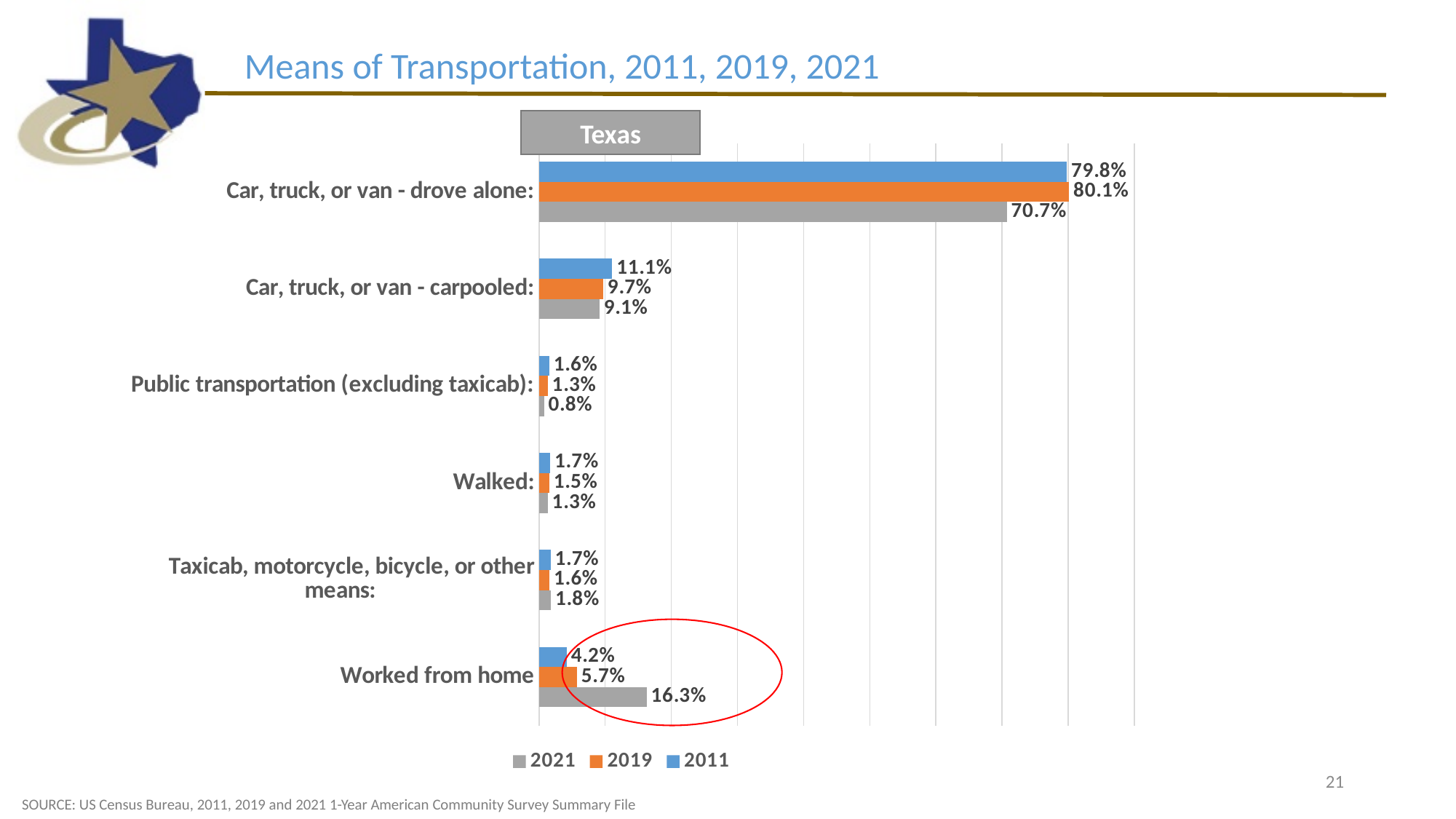
Which category has the lowest 2011 value? Public transportation (excluding taxicab) Which category has the highest 2021 value? Car, truck, or van - drove alone What is the 2011 value for Car, truck, or van - drove alone? 79.8% What is the 2021 value for Public transportation (excluding taxicab)? 0.8% What is the difference between the 2021 and 2019 values for Worked from home? 10.6% What is the 2019 value for Car, truck, or van - carpooled? 9.7% What kind of chart is shown on the slide? Bar chart How many series does the legend list? 3 What is the 2021 value for Worked from home? 16.3% Which is larger for Walked: the 2011 value or the 2021 value? 2011 What is the difference between the 2019 and 2021 values for Car, truck, or van - drove alone? 9.4% How many transportation categories are shown on the chart? 6